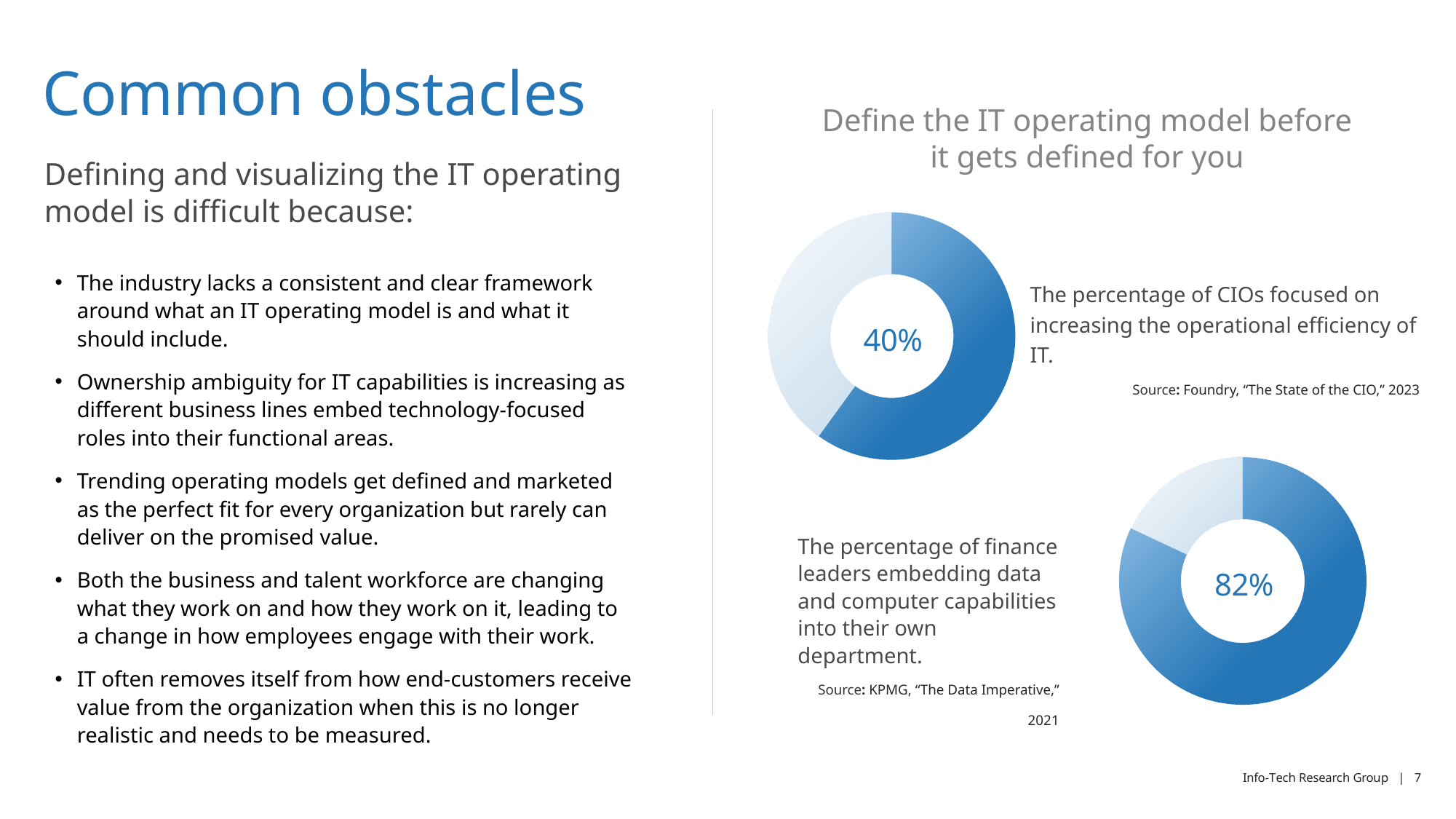
In the lower chart, what percentage of finance leaders are embedding data and computer capabilities into their own department? 82% How many donut charts are shown on the slide? 2 What kind of chart is used to show the percentage of CIOs focused on increasing the operational efficiency of IT? Donut (pie) chart In the upper chart, what share of the donut is represented by the lighter, unfilled portion? 60% What is the source cited for the 40% CIO statistic? Foundry, "The State of the CIO," 2023 In the upper chart, is the value for CIOs focused on operational efficiency greater or less than 50%? less In the lower chart, is the value for finance leaders greater or less than 75%? greater Which chart shows the larger percentage: the CIO operational efficiency chart or the finance leaders chart? The finance leaders chart (82%) In the upper chart, what percentage of CIOs are focused on increasing the operational efficiency of IT? 40% What is the heading above the two donut charts on the right side of the slide? Define the IT operating model before it gets defined for you What is the difference between the percentage shown in the finance leaders chart and the percentage shown in the CIO chart? 42 percentage points